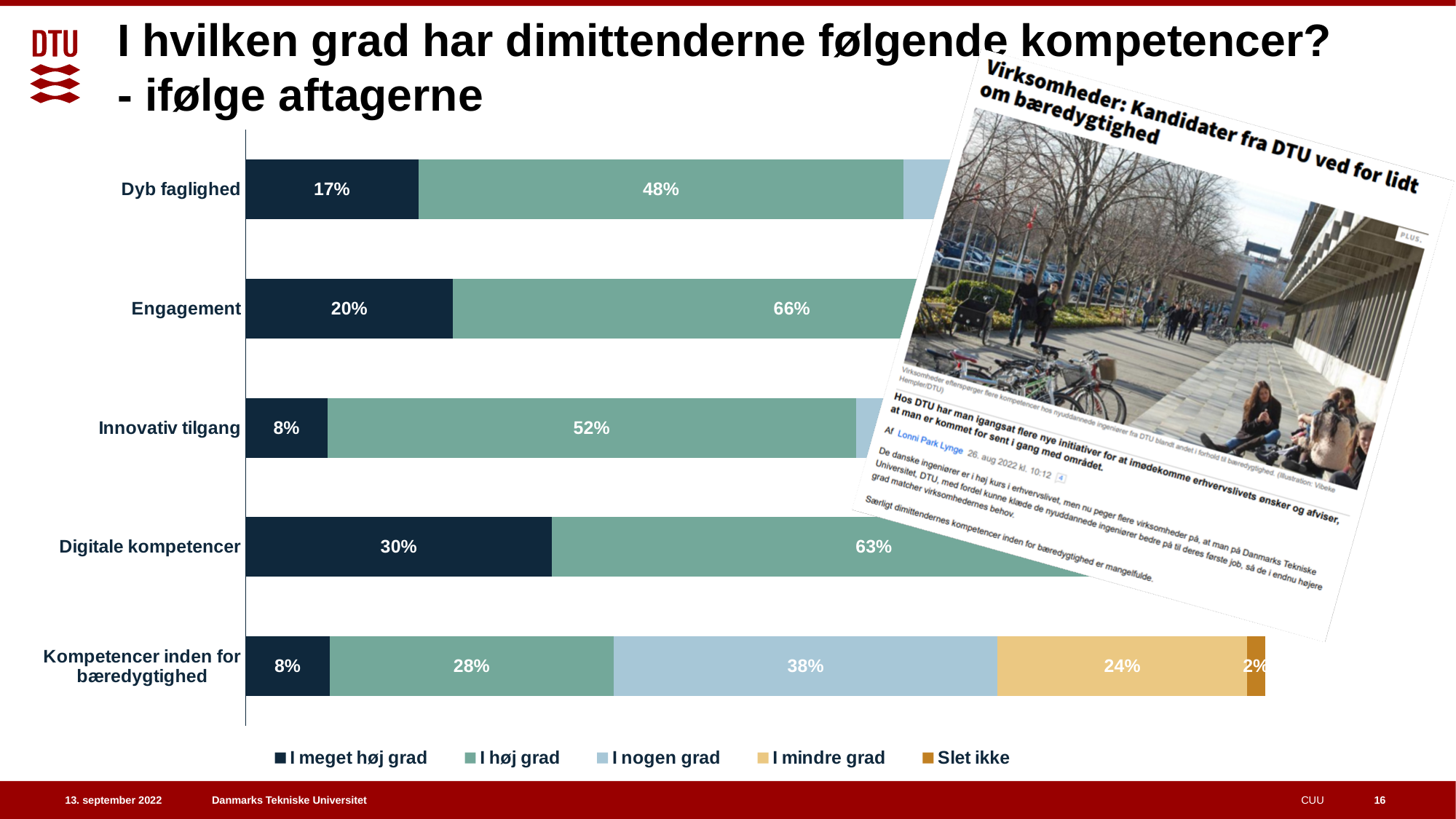
What is the difference between the 'I høj grad' values for Engagement and Dyb faglighed? 18% How many series does the legend list? 5 What is the 'Slet ikke' value for Kompetencer inden for bæredygtighed? 2% Which category has the lowest 'I høj grad' value? Kompetencer inden for bæredygtighed What is the 'I høj grad' value for Engagement? 66% What kind of chart is shown on the slide? Stacked bar chart What is the 'I nogen grad' value for Kompetencer inden for bæredygtighed? 38% How many competency categories are plotted on the chart? 5 What is the total of all segments in the Kompetencer inden for bæredygtighed bar? 100% Which is larger: the 'I meget høj grad' value for Engagement or for Dyb faglighed? Engagement What is the 'I meget høj grad' value for Digitale kompetencer? 30% Which category has the highest 'I meget høj grad' value? Digitale kompetencer